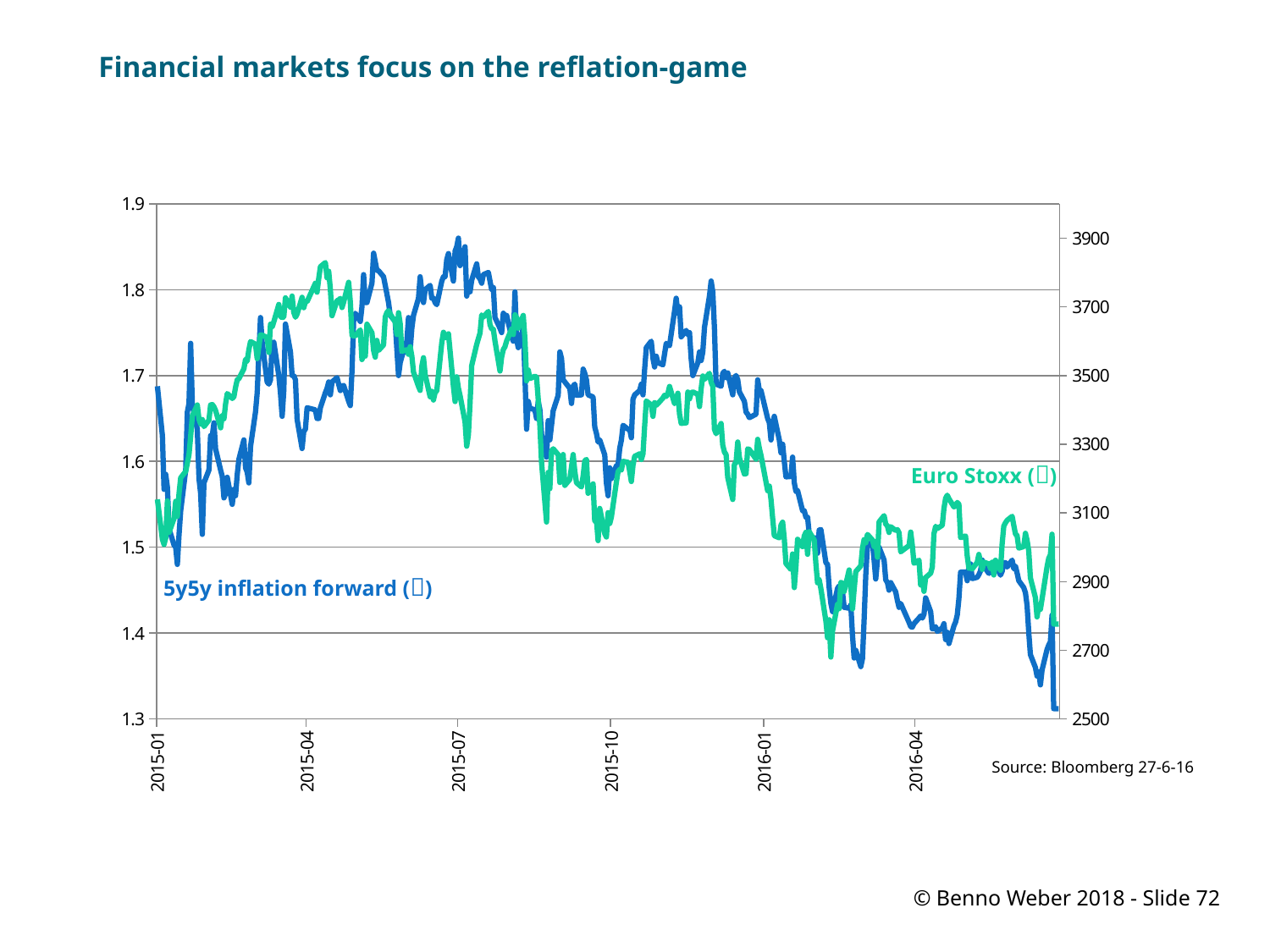
What is the highest tick value shown on the left-hand axis? 1.9 Is the value of the Euro Stoxx at 2016-01 greater or less than 3300? less What is the lowest tick value shown on the right-hand axis? 2500 Does the Euro Stoxx rise or fall between 2015-01 and 2015-04? rise Is the value of the Euro Stoxx at 2015-04 greater or less than 3500? greater Which series is plotted in blue? 5y5y inflation forward Does the 5y5y inflation forward rise or fall between 2015-07 and the end of the series? fall How many data series are plotted on the chart? 2 What kind of chart is shown on the slide? Line chart Is the value of the 5y5y inflation forward at 2016-04 greater or less than 1.5? less